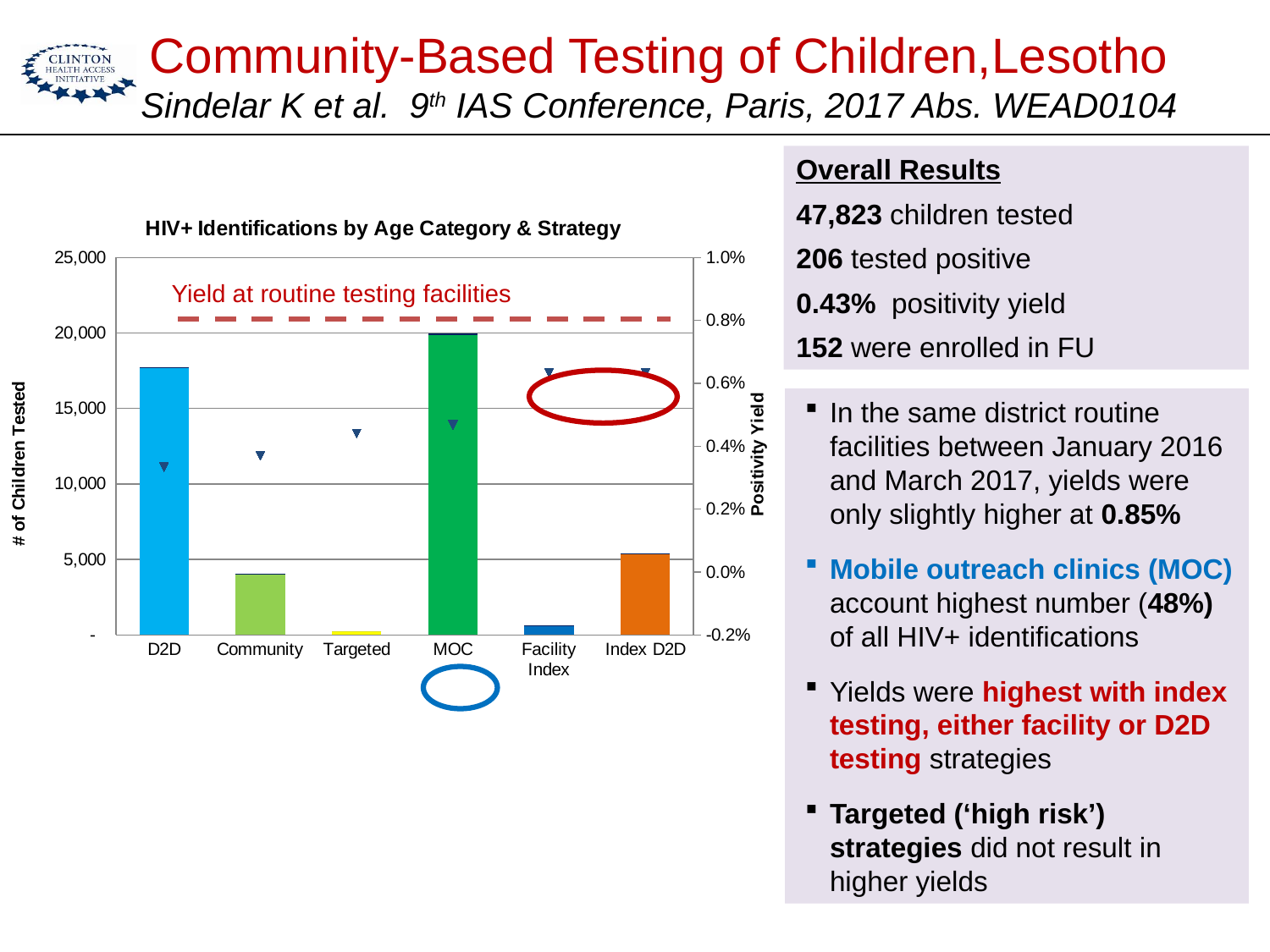
Which strategy has the lowest number of children tested? Targeted What kind of chart is shown on the slide? combination bar and line chart Is the number of children tested for D2D greater or less than 15,000? greater Which has more children tested, D2D or Community? D2D Is the number of children tested for MOC greater or less than 15,000? greater Is the number of children tested for Index D2D greater or less than 10,000? less What is the title of the chart? HIV+ Identifications by Age Category & Strategy How many strategy categories are shown on the x axis of the chart? 6 Which has a higher positivity yield, Facility Index or D2D? Facility Index Which strategy has the highest number of children tested? MOC